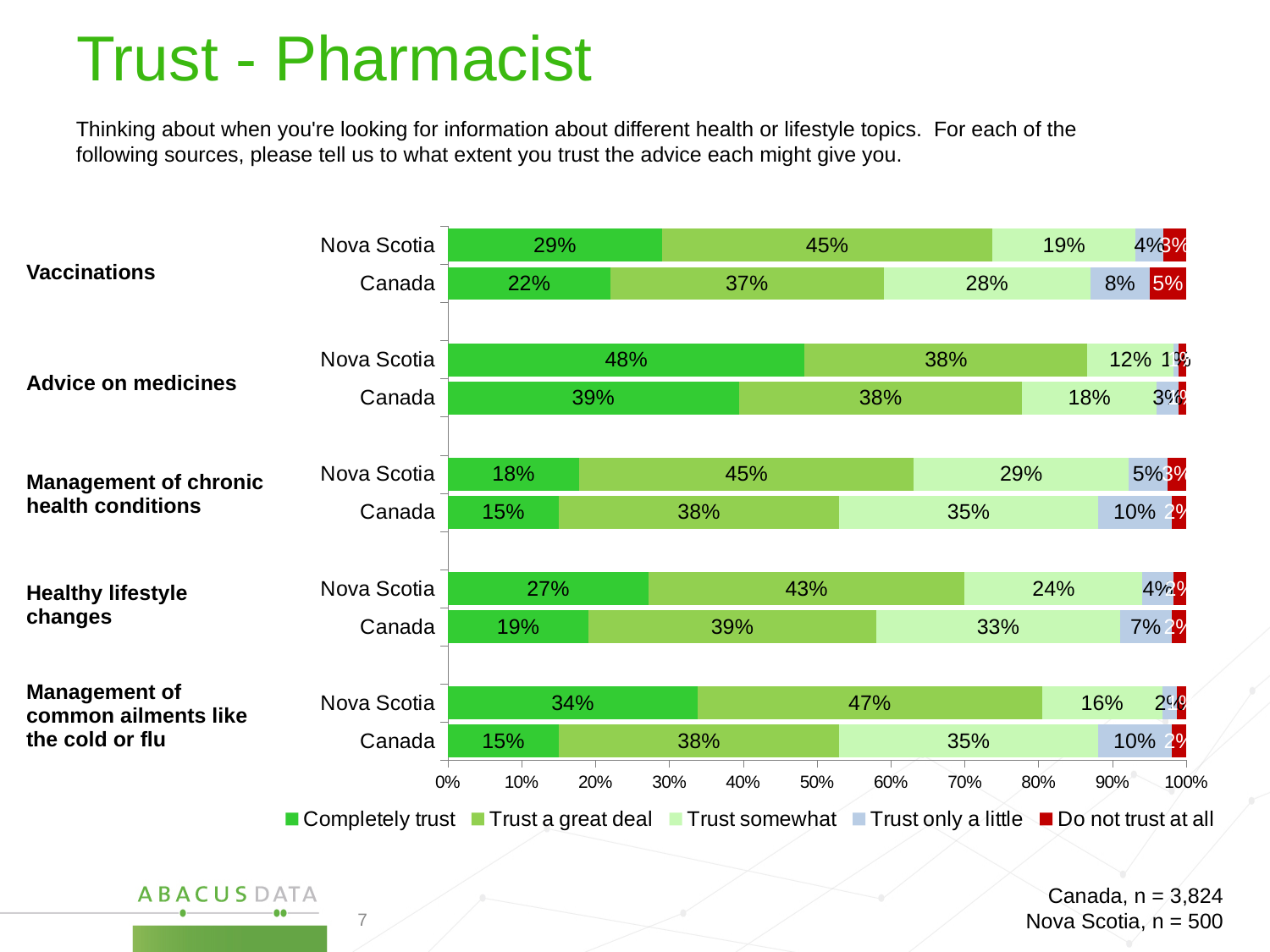
What kind of chart is shown on the slide? Stacked bar chart Among the Nova Scotia bars, which topic has the lowest 'Completely trust' percentage? Management of chronic health conditions How many bars are plotted in the chart? 10 What colour represents 'Do not trust at all' in the chart? Red What is the 'Trust a great deal' value for Nova Scotia on management of common ailments like the cold or flu? 47% For vaccinations, what share of Canada respondents say they trust a pharmacist somewhat? 28% What is the 'Trust only a little' value for Canada on management of chronic health conditions? 10% Among the Nova Scotia bars, which topic has the highest 'Completely trust' percentage? Advice on medicines How many series does the legend list? 5 What percentage of Nova Scotia respondents say they completely trust a pharmacist for advice on medicines? 48% For healthy lifestyle changes, which has the larger 'Trust somewhat' value, Nova Scotia or Canada? Canada For vaccinations, how many percentage points higher is the 'Completely trust' value for Nova Scotia than for Canada? 7 percentage points